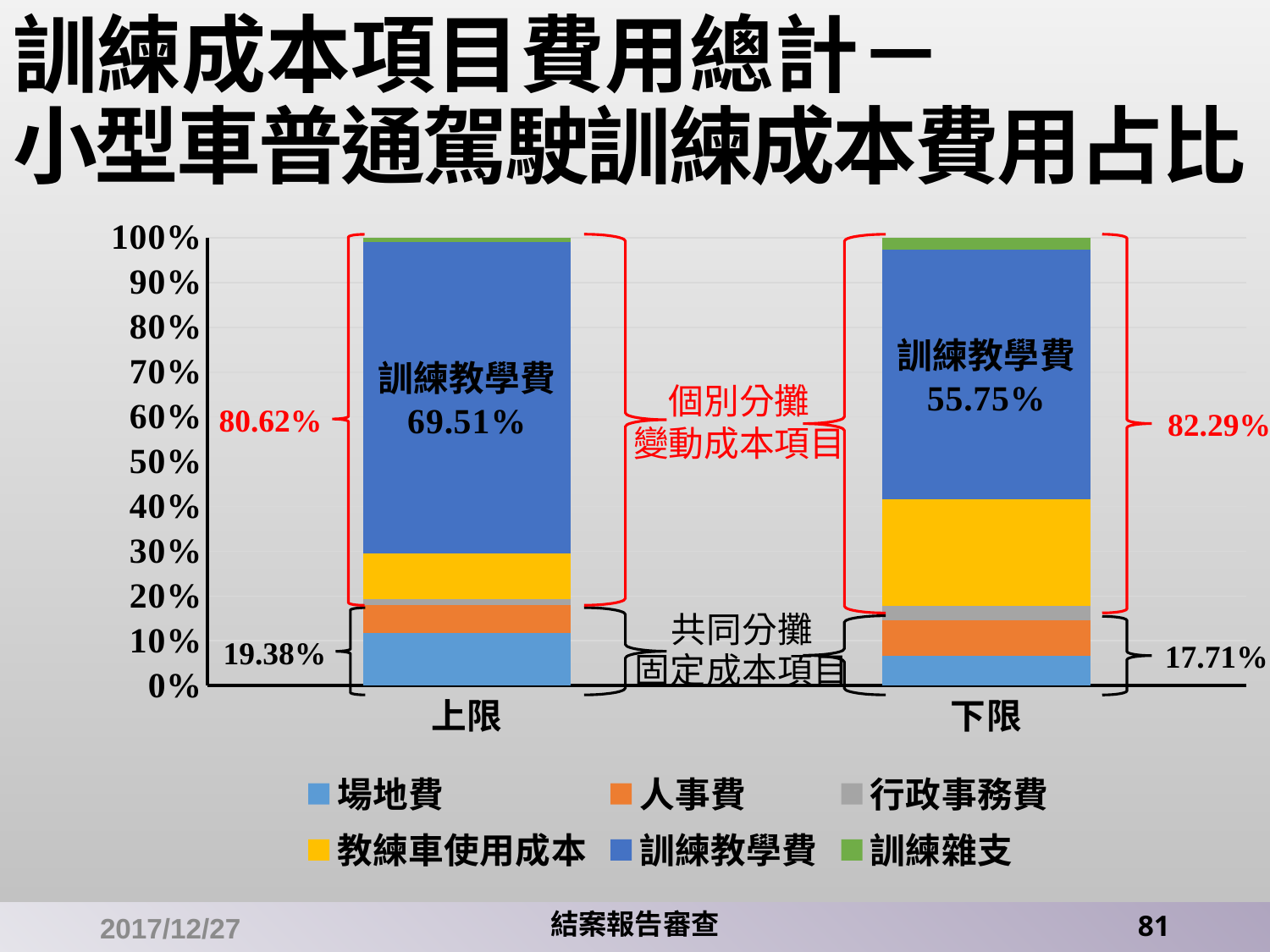
What is the value of 訓練教學費 for 上限? 69.51% What share of 上限 is labelled as 個別分攤變動成本項目? 80.62% How many categories are shown on the x axis? 2 Is the 教練車使用成本 segment for 下限 greater or less than 20%? greater How many series does the legend list? 6 What is the value of 訓練教學費 for 下限? 55.75% What share of 下限 is labelled as 共同分攤固定成本項目? 17.71% What share of 下限 is labelled as 個別分攤變動成本項目? 82.29% Which category has the larger 教練車使用成本 segment, 上限 or 下限? 下限 Which category has the larger 訓練教學費 share, 上限 or 下限? 上限 What is the difference between the 訓練教學費 share for 上限 and for 下限? 13.76% What kind of chart is shown on the slide? Stacked bar chart